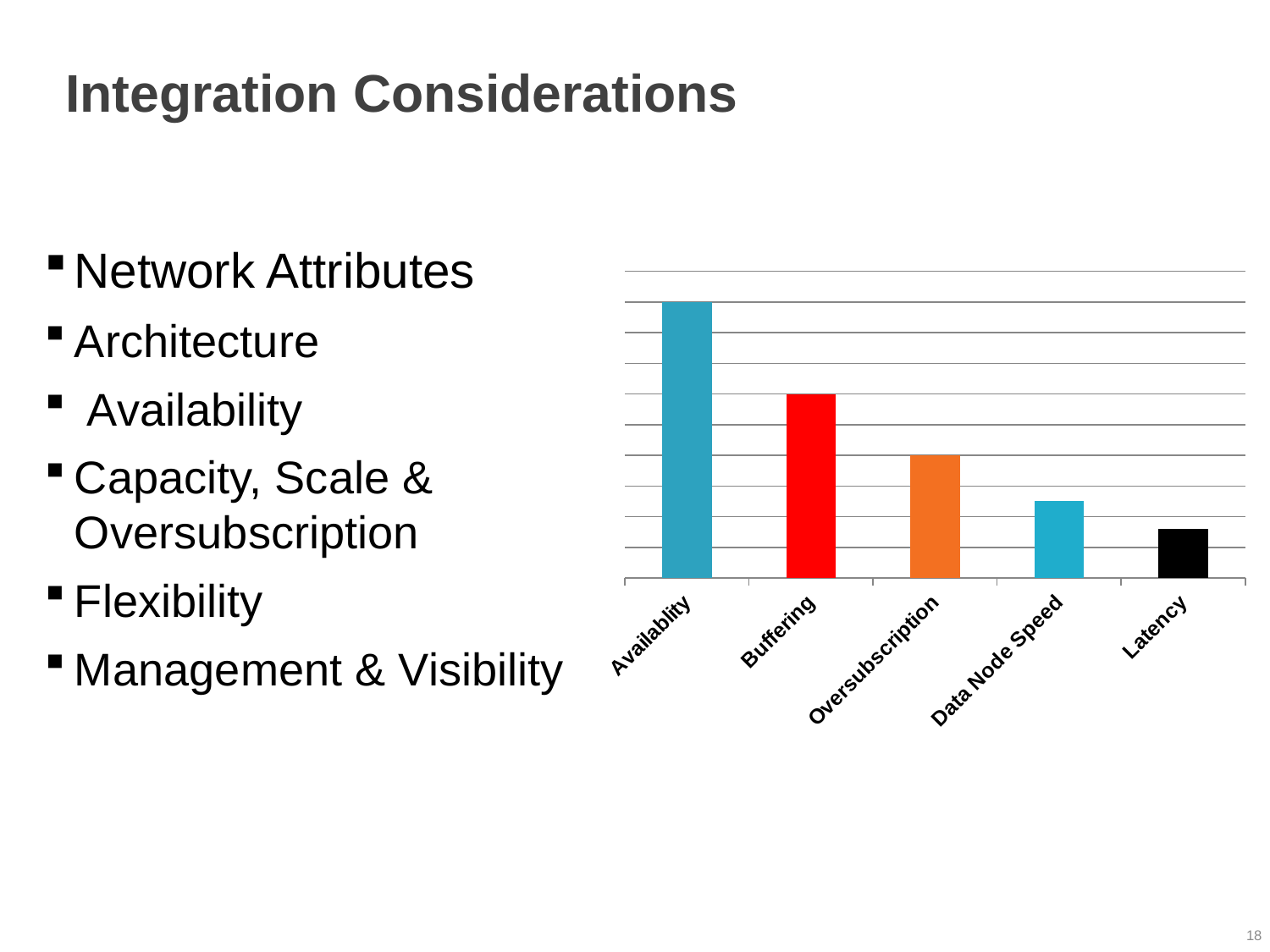
Which category has the tallest bar in the chart? Availablity Which is larger, the bar for Availability or the bar for Data Node Speed? Availability What kind of chart is shown on the slide? Bar chart Which is larger, the bar for Buffering or the bar for Oversubscription? Buffering Do the bar heights rise or fall from left to right across the x axis? Fall What colour is the bar for Latency? Black What is the label of the second category from the left on the x axis? Buffering Which is larger, the bar for Data Node Speed or the bar for Latency? Data Node Speed Which category has the shortest bar in the chart? Latency How many categories are shown on the x axis of the chart? 5